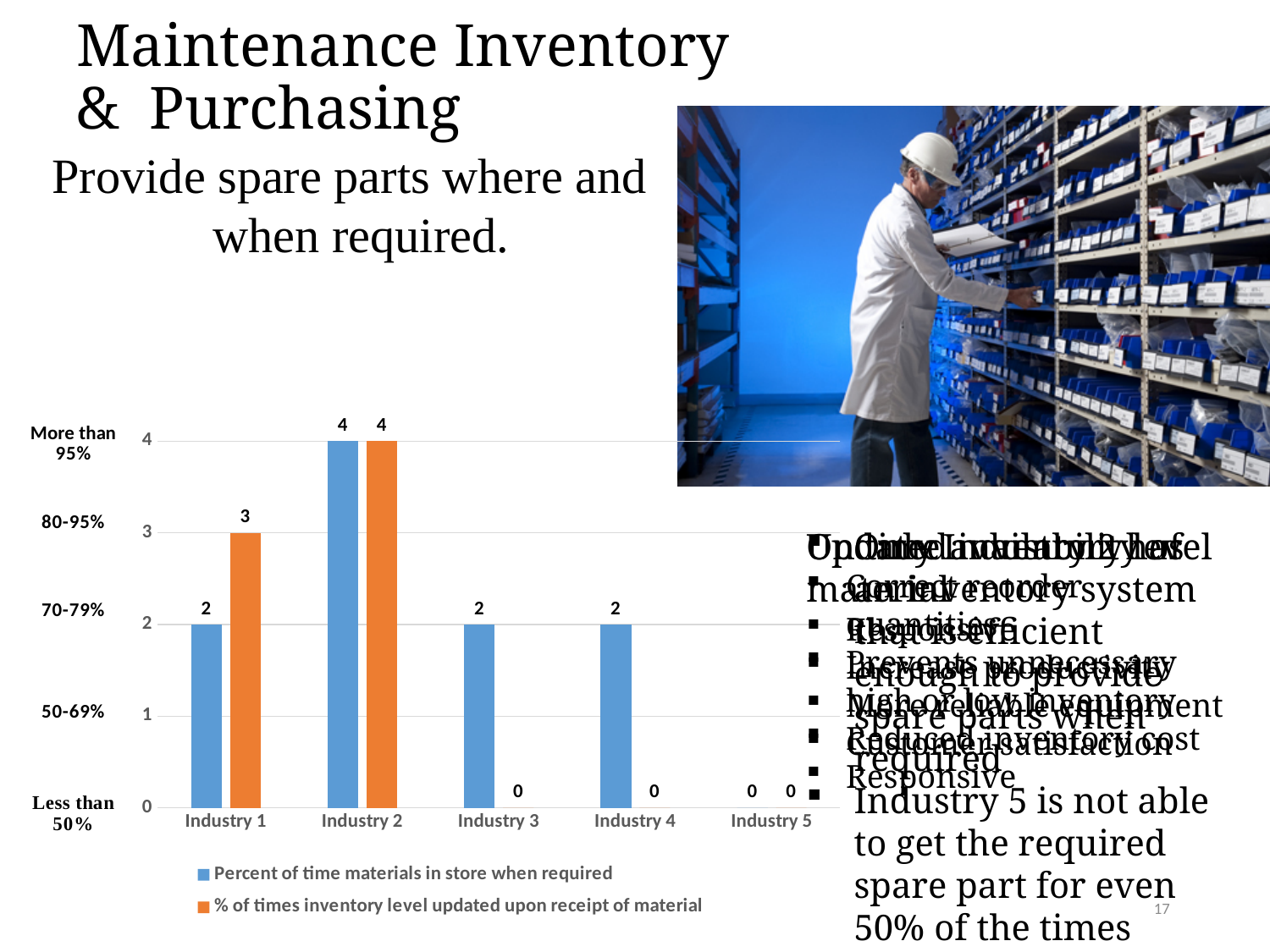
What is the value of 'Percent of time materials in store when required' for Industry 1? 2 For Industry 4, which series has the larger value: 'Percent of time materials in store when required' or '% of times inventory level updated upon receipt of material'? Percent of time materials in store when required How many industries are shown on the x axis of the chart? 5 What is the value of 'Percent of time materials in store when required' for Industry 2? 4 Which colour represents '% of times inventory level updated upon receipt of material' in the chart? Orange What type of chart is shown on the slide? Bar chart What is the difference between the two series' values for Industry 1? 1 Which industry has the lowest value for 'Percent of time materials in store when required'? Industry 5 What is the value of '% of times inventory level updated upon receipt of material' for Industry 3? 0 How many series does the chart legend list? 2 What is the value of '% of times inventory level updated upon receipt of material' for Industry 1? 3 Which industry has the highest value for 'Percent of time materials in store when required'? Industry 2